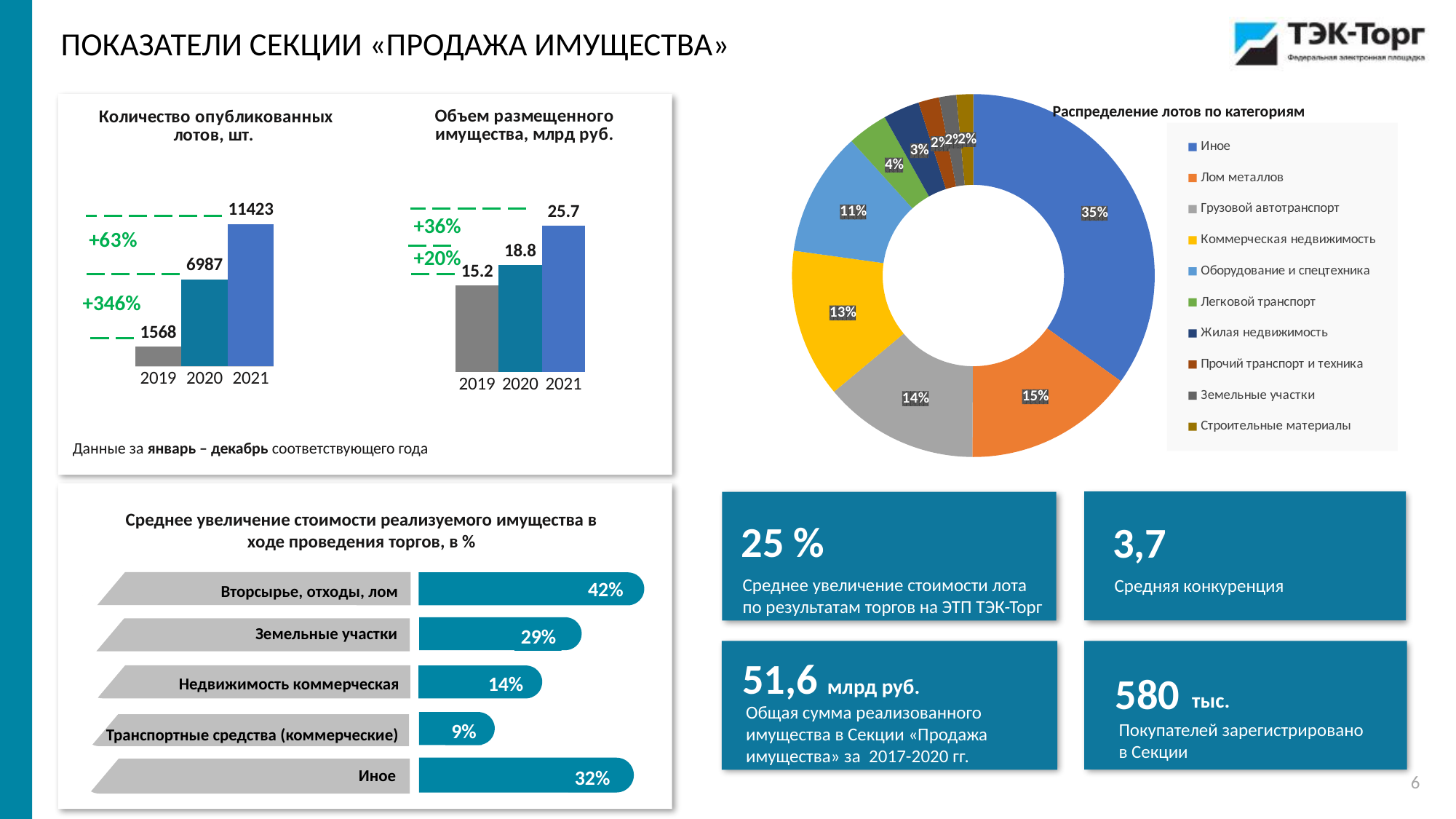
What kind of chart is 'Распределение лотов по категориям'? pie chart (donut) In the chart 'Объем размещенного имущества, млрд руб.', what is the value for 2020? 18.8 In the chart 'Среднее увеличение стоимости реализуемого имущества в ходе проведения торгов, в %', how many categories are shown? 5 In the chart 'Среднее увеличение стоимости реализуемого имущества в ходе проведения торгов, в %', what is the value for 'Земельные участки'? 29% In the chart 'Объем размещенного имущества, млрд руб.', what is the difference between the 2021 and 2019 values? 10.5 In the chart 'Количество опубликованных лотов, шт.', do the values rise or fall from 2019 to 2021? rise In the chart 'Количество опубликованных лотов, шт.', what is the value for 2021? 11423 In the chart 'Среднее увеличение стоимости реализуемого имущества в ходе проведения торгов, в %', which category has the lowest value? Транспортные средства (коммерческие) In the chart 'Распределение лотов по категориям', which category has the largest share? Иное How many entries does the legend of the chart 'Распределение лотов по категориям' list? 10 In the chart 'Распределение лотов по категориям', what share does 'Лом металлов' have? 15% In the chart 'Количество опубликованных лотов, шт.', what is the value for 2019? 1568